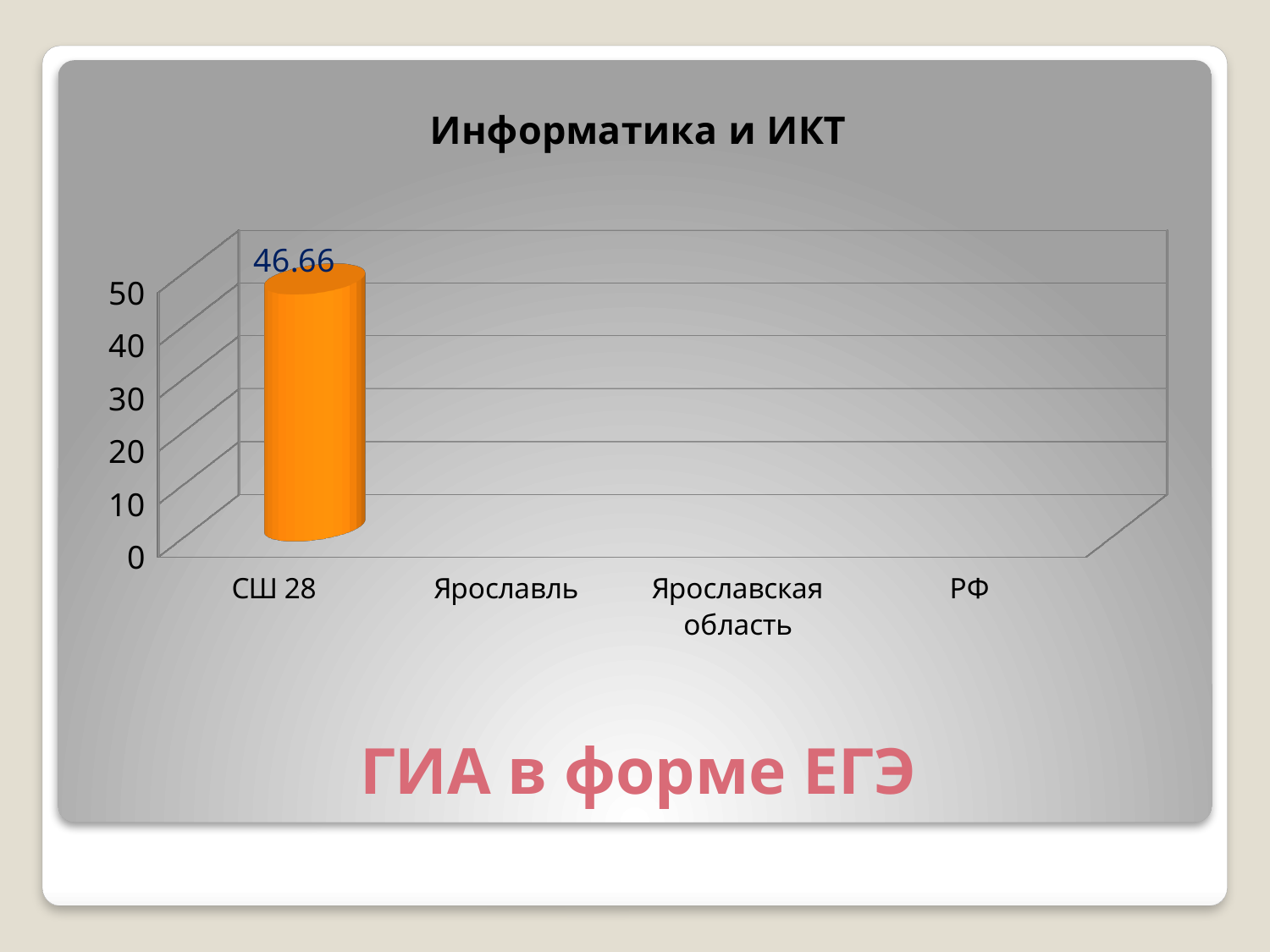
What is the title of the chart? Информатика и ИКТ What colour is the bar for СШ 28? orange Is the value for СШ 28 greater or less than 50? less Is the value for СШ 28 greater or less than 30? greater How many categories are listed on the x axis of the chart? 4 Which category is listed last on the x axis? РФ What is the value shown for СШ 28? 46.66 What kind of chart is shown on the slide? bar chart Is the value for СШ 28 greater or less than 40? greater Which category has the highest value in the chart? СШ 28